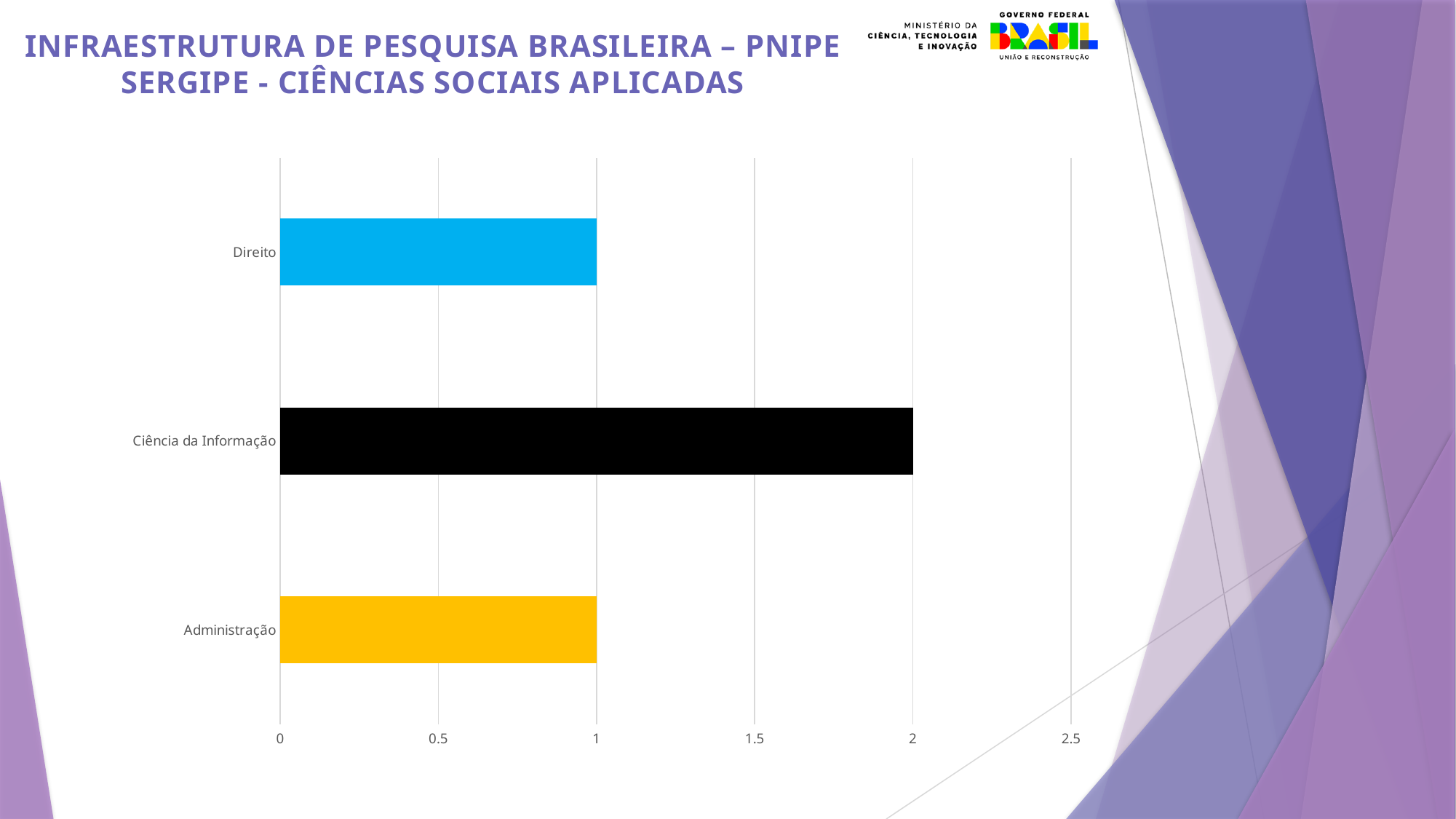
How many categories are plotted in the chart? 3 What colour is the bar for Ciência da Informação? black Which category has the highest value? Ciência da Informação Is the value for Administração greater or less than 1.5? less What is the difference between the values for Ciência da Informação and Direito? 1 What kind of chart is shown on the slide? bar chart What is the value for Ciência da Informação? 2 Which is larger, the value for Ciência da Informação or the value for Administração? Ciência da Informação Is the value for Ciência da Informação greater or less than 1.5? greater What is the value for Administração? 1 What is the highest value shown on the x axis? 2.5 What is the value for Direito? 1